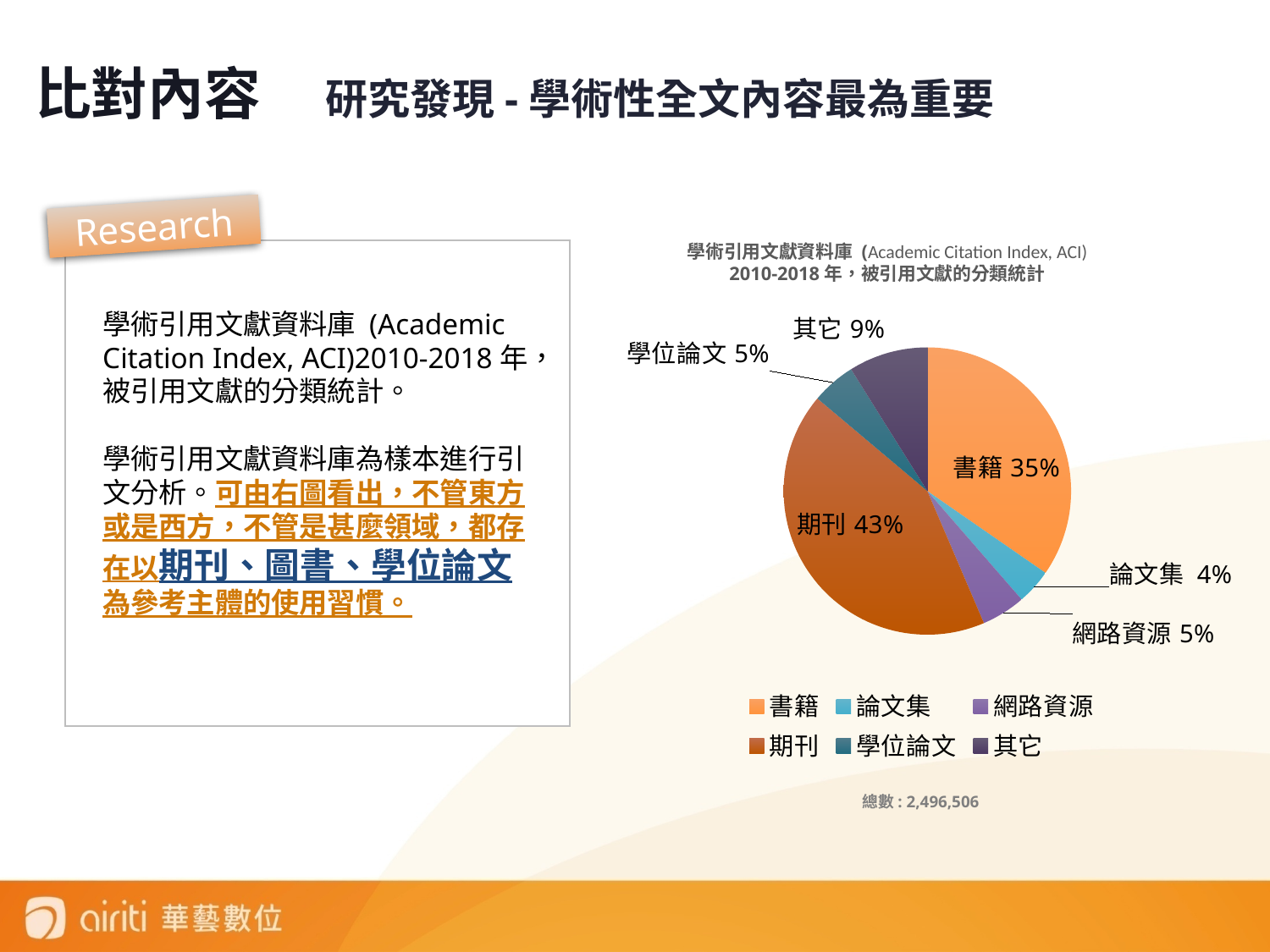
What percentage is shown for 學位論文 in the pie chart? 5% What percentage of the pie chart is 書籍? 35% How many categories does the pie chart have? 6 What type of chart is shown on the slide? pie chart Which category has the smallest slice in the pie chart? 論文集 What percentage is shown for 論文集 in the pie chart? 4% What total number (總數) is shown below the pie chart? 2,496,506 Which category has the largest slice in the pie chart? 期刊 What is the difference in percentage points between 期刊 and 書籍? 8 What percentage of the pie chart is 期刊? 43% What share does 其它 have in the pie chart? 9% Which is larger in the pie chart, 書籍 or 其它? 書籍